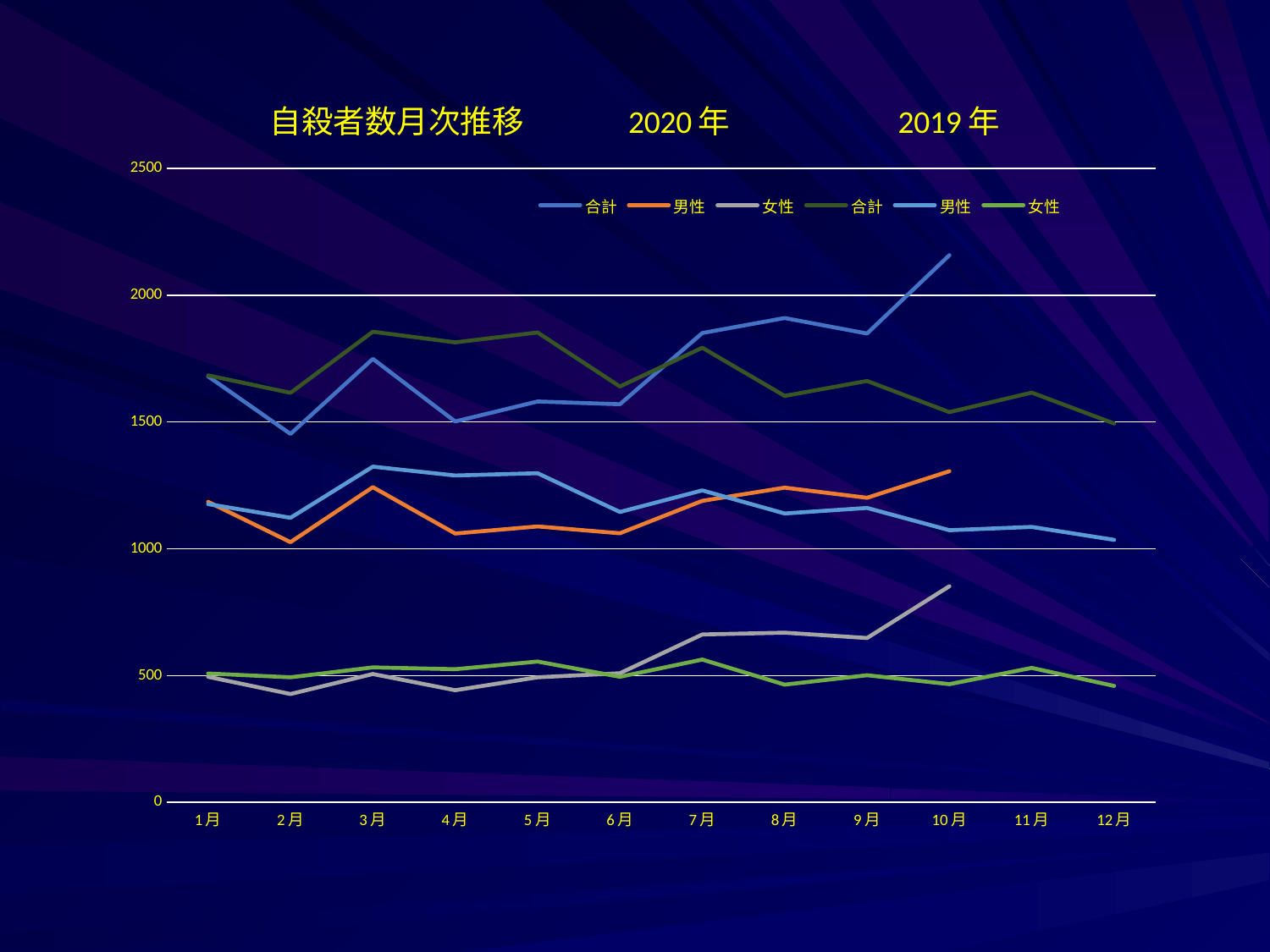
Does the 2020年 合計 line rise or fall from 9月 to 10月? rise What kind of chart is shown on the slide? line chart Is the value of the 2020年 合計 line at 10月 greater or less than 2000? greater Is the value of the 2019年 合計 line at 3月 greater or less than 1500? greater Which two years are compared in the chart? 2020年 and 2019年 Is the value of the 2020年 女性 line at 10月 greater or less than 1000? less At 10月, which is larger: the 2020年 合計 value or the 2019年 合計 value? 2020年 合計 How many months are shown on the x axis? 12 How many series does the legend list? 6 What is the title of the chart? 自殺者数月次推移 2020年 2019年 In which month does the 2020年 合計 line reach its highest value? 10月